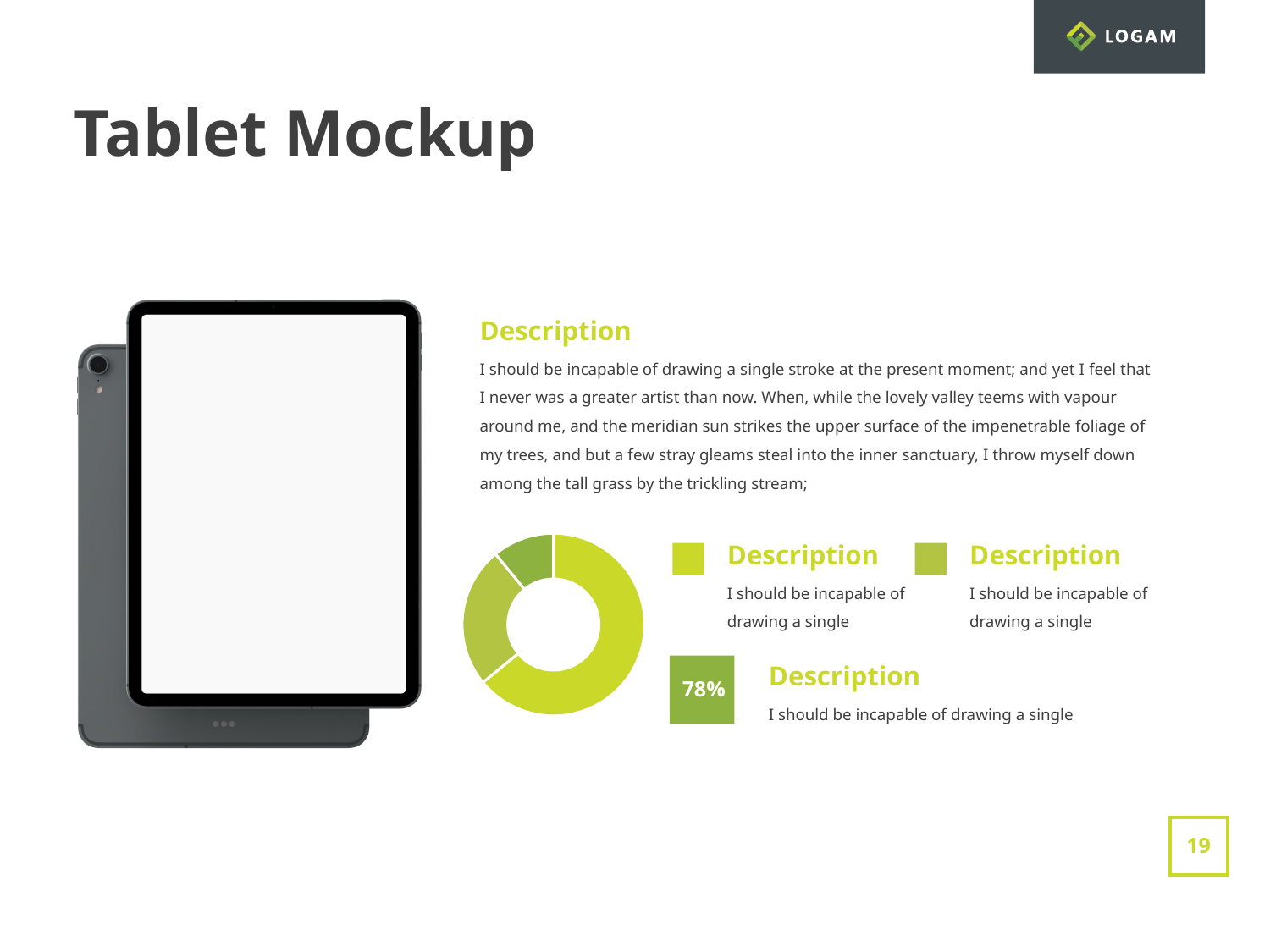
Is the largest slice of the doughnut chart more or less than half of the whole? more Which slice of the doughnut chart is the largest? the light yellow-green slice Which slice of the doughnut chart is the smallest? the dark green slice at the top What kind of chart is shown on the slide? doughnut chart How many slices does the doughnut chart have? 3